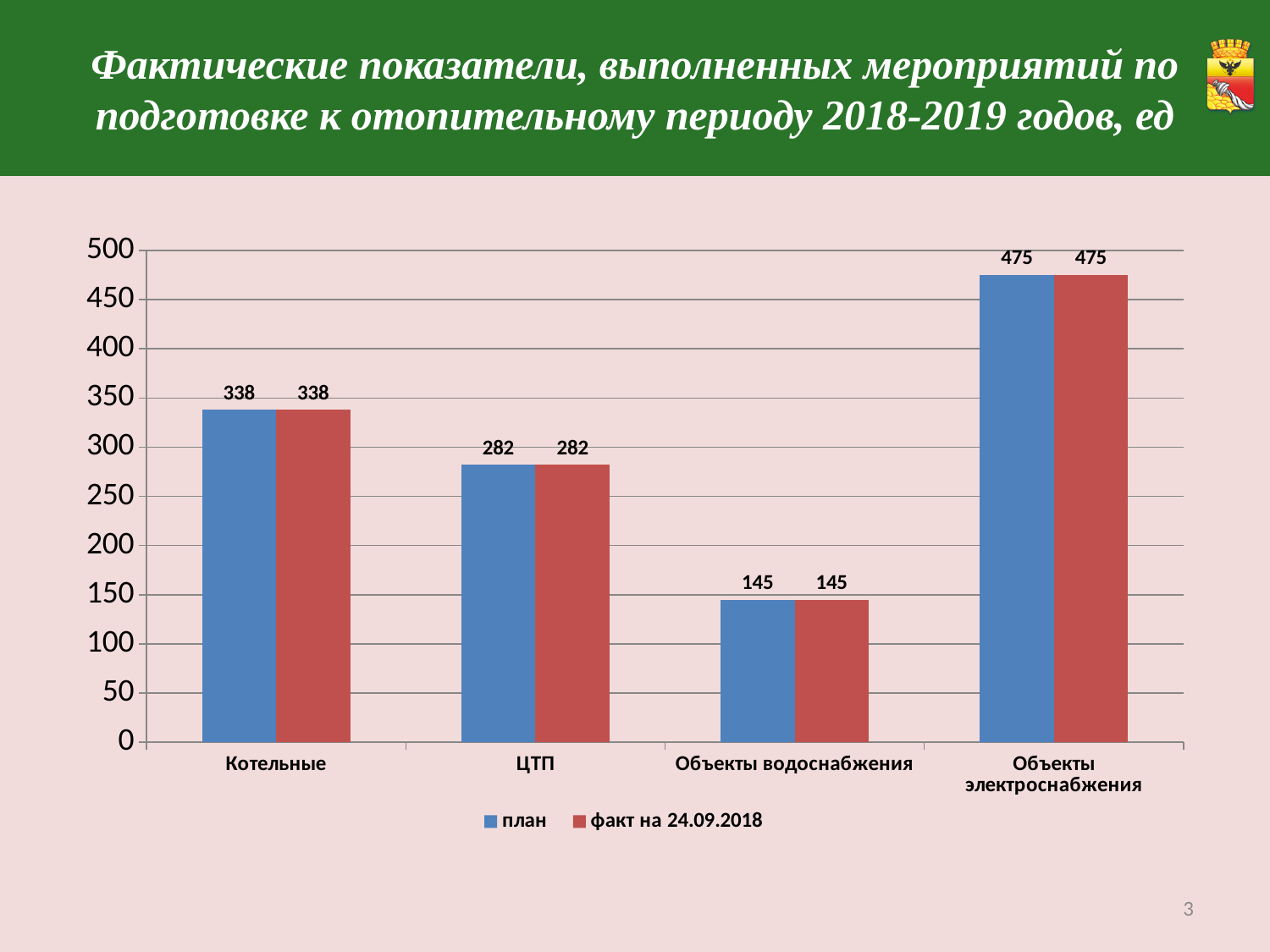
What is the difference between the план values for Объекты электроснабжения and Котельные? 137 How many series does the legend list? 2 Which category has the highest план value? Объекты электроснабжения What is the план value for Котельные? 338 What kind of chart is shown on the slide? bar chart Is the факт на 24.09.2018 value for Котельные greater or less than 300? greater What is the факт на 24.09.2018 value for Объекты электроснабжения? 475 How many categories are shown on the x axis? 4 Which is larger: the план value for ЦТП or the план value for Объекты водоснабжения? ЦТП What is the факт на 24.09.2018 value for ЦТП? 282 What is the план value for Объекты водоснабжения? 145 Which category has the lowest факт на 24.09.2018 value? Объекты водоснабжения